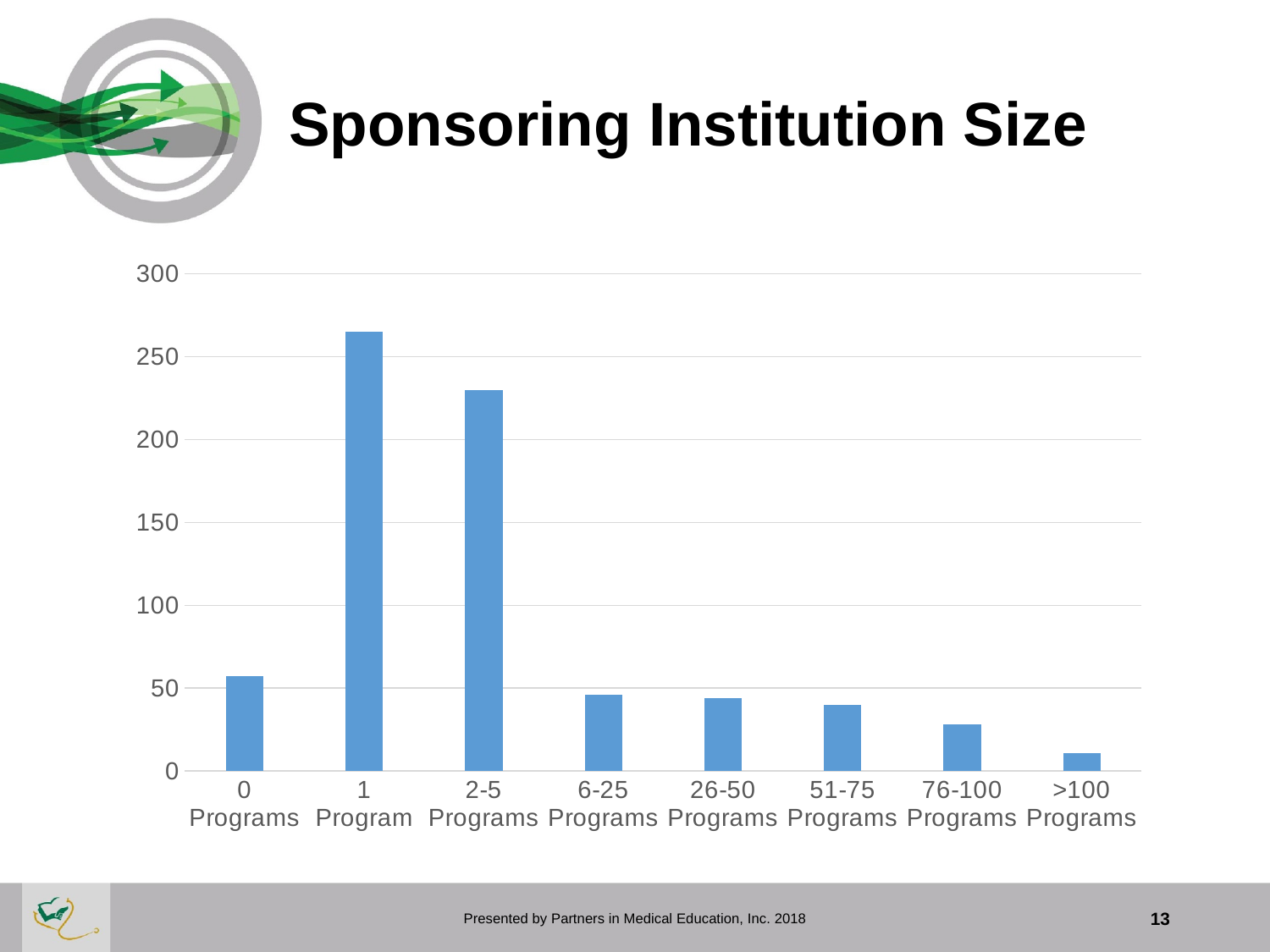
Which category has the lowest value? >100 Programs How many categories are shown on the x axis? 8 Which category has the highest value? 1 Program Which is larger, the value for 0 Programs or the value for 6-25 Programs? 0 Programs Is the value for 76-100 Programs greater or less than 50? less Do the values rise or fall along the x axis from 2-5 Programs to >100 Programs? fall What is the title of the chart? Sponsoring Institution Size Is the value for 1 Program greater or less than 250? greater Is the value for 0 Programs greater or less than 50? greater What kind of chart is shown on the slide? bar chart Which is larger, the value for 1 Program or the value for 2-5 Programs? 1 Program